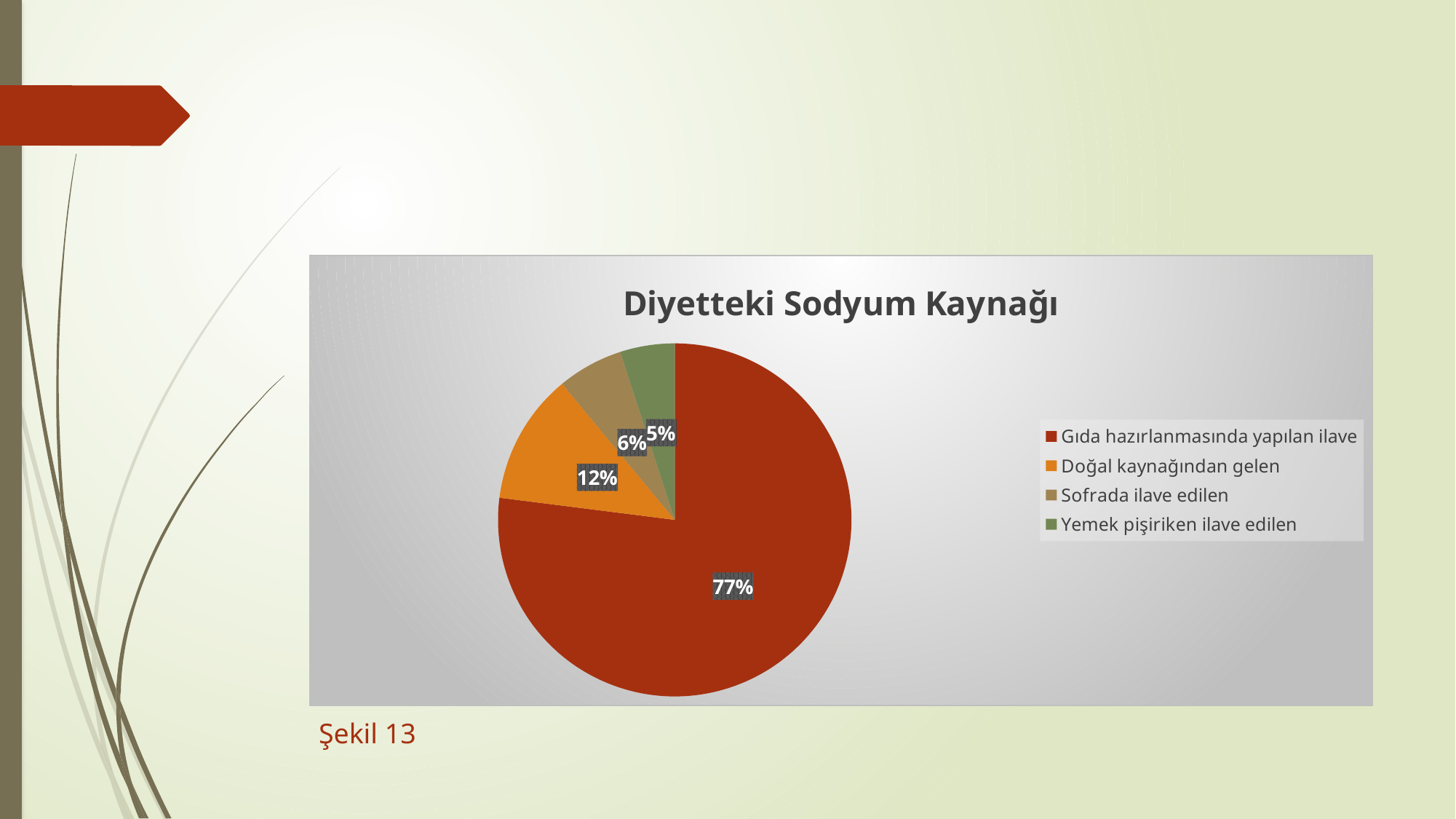
What is the difference between the shares of 'Gıda hazırlanmasında yapılan ilave' and 'Doğal kaynağından gelen'? 65% What share of the pie is 'Gıda hazırlanmasında yapılan ilave'? 77% How many categories does the pie chart show? 4 What share of the pie is 'Sofrada ilave edilen'? 6% What colour is the slice for 'Doğal kaynağından gelen'? orange What share of the pie is 'Yemek pişiriken ilave edilen'? 5% Which category has the largest slice of the pie? Gıda hazırlanmasında yapılan ilave Which category has the smallest slice of the pie? Yemek pişiriken ilave edilen What is the title of the chart? Diyetteki Sodyum Kaynağı Which is larger, the share for 'Doğal kaynağından gelen' or the share for 'Sofrada ilave edilen'? Doğal kaynağından gelen What kind of chart is shown on the slide? pie chart